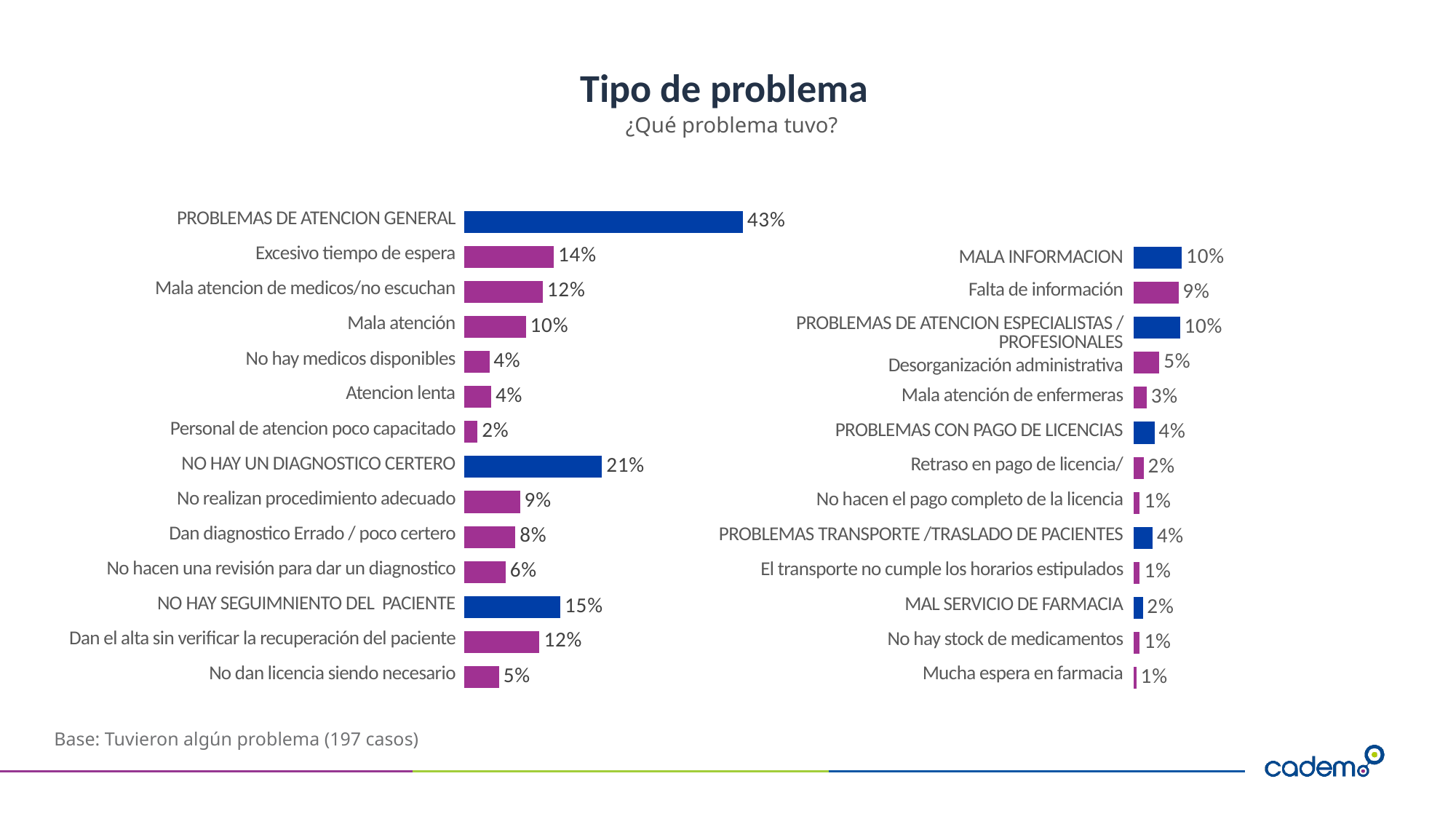
In the right chart, which category has the highest value? MALA INFORMACION and PROBLEMAS DE ATENCION ESPECIALISTAS / PROFESIONALES (both 10%) In the left chart, what is the value for Excesivo tiempo de espera? 14% In the right chart, what is the value for Desorganización administrativa? 5% How many categories are shown in the left chart? 14 In the left chart, what is the difference between NO HAY UN DIAGNOSTICO CERTERO and NO HAY SEGUIMNIENTO DEL PACIENTE? 6% In the left chart, what is the value for PROBLEMAS DE ATENCION GENERAL? 43% What kind of chart is used on this slide? Bar chart In the right chart, which is larger: Falta de información or Mala atención de enfermeras? Falta de información In the left chart, which category has the lowest value? Personal de atencion poco capacitado In the left chart, which category has the highest value? PROBLEMAS DE ATENCION GENERAL In the right chart, what is the value for PROBLEMAS CON PAGO DE LICENCIAS? 4% What is the title of the slide's chart? Tipo de problema